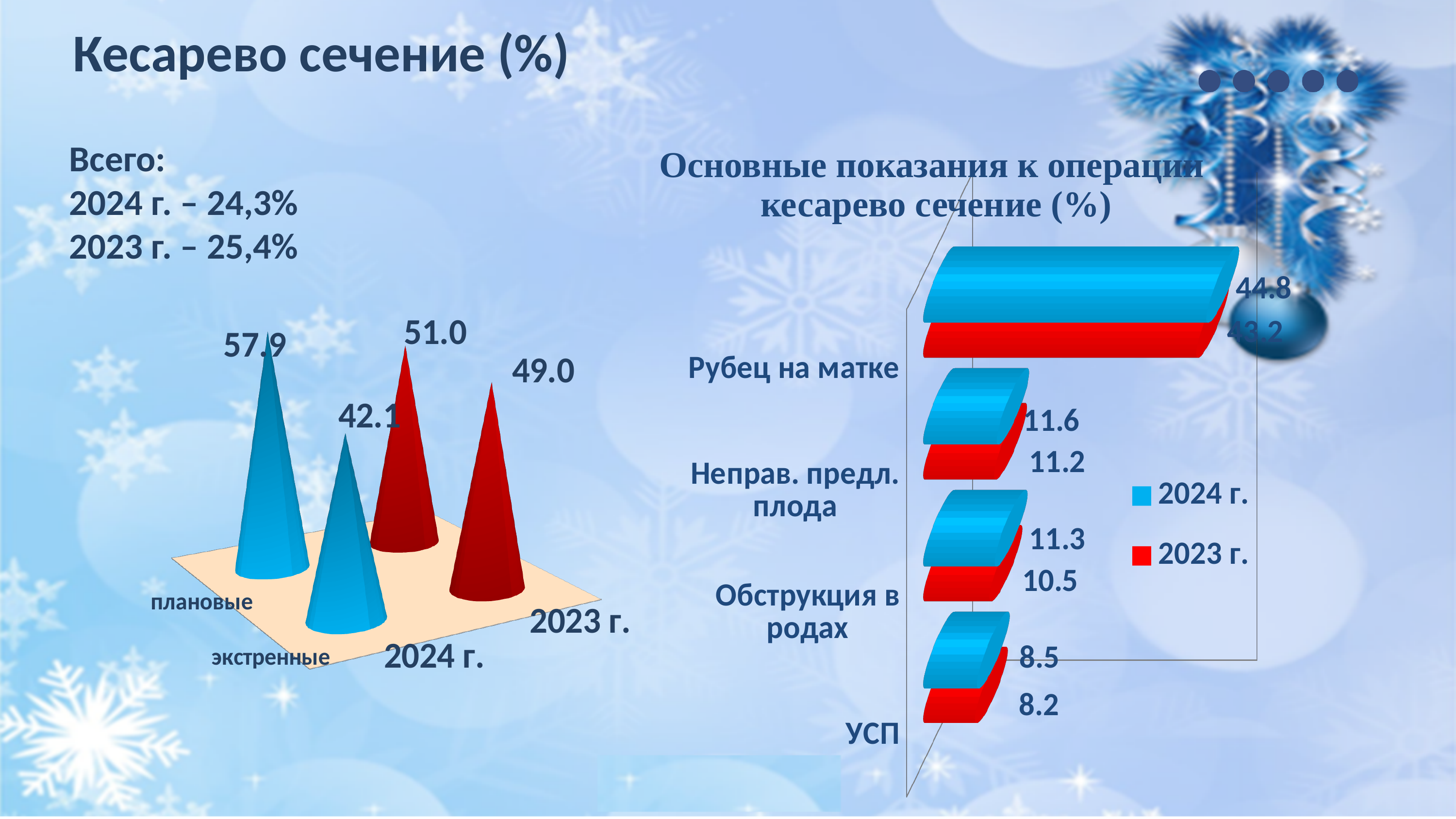
In the chart 'Основные показания к операции кесарево сечение (%)', which category has the lowest value? УСП In the left chart, which is larger: плановые in 2024 г. or плановые in 2023 г.? плановые in 2024 г. In the chart 'Основные показания к операции кесарево сечение (%)', what is the 2023 г. value for Обструкция в родах? 10.5 What kind of chart is 'Основные показания к операции кесарево сечение (%)'? bar chart In the left chart, what is the value for экстренные in 2023 г.? 49.0 In the chart 'Основные показания к операции кесарево сечение (%)', which category has the highest value? Рубец на матке In the left chart, how many categories are shown? 2 In the left chart, what is the difference between the 2024 г. values for плановые and экстренные? 15.8 In the chart 'Основные показания к операции кесарево сечение (%)', how many series does the legend list? 2 In the chart 'Основные показания к операции кесарево сечение (%)', what is the difference between the 2024 г. and 2023 г. values for УСП? 0.3 In the left chart, what is the value for плановые in 2024 г.? 57.9 In the chart 'Основные показания к операции кесарево сечение (%)', what is the 2024 г. value for Рубец на матке? 44.8